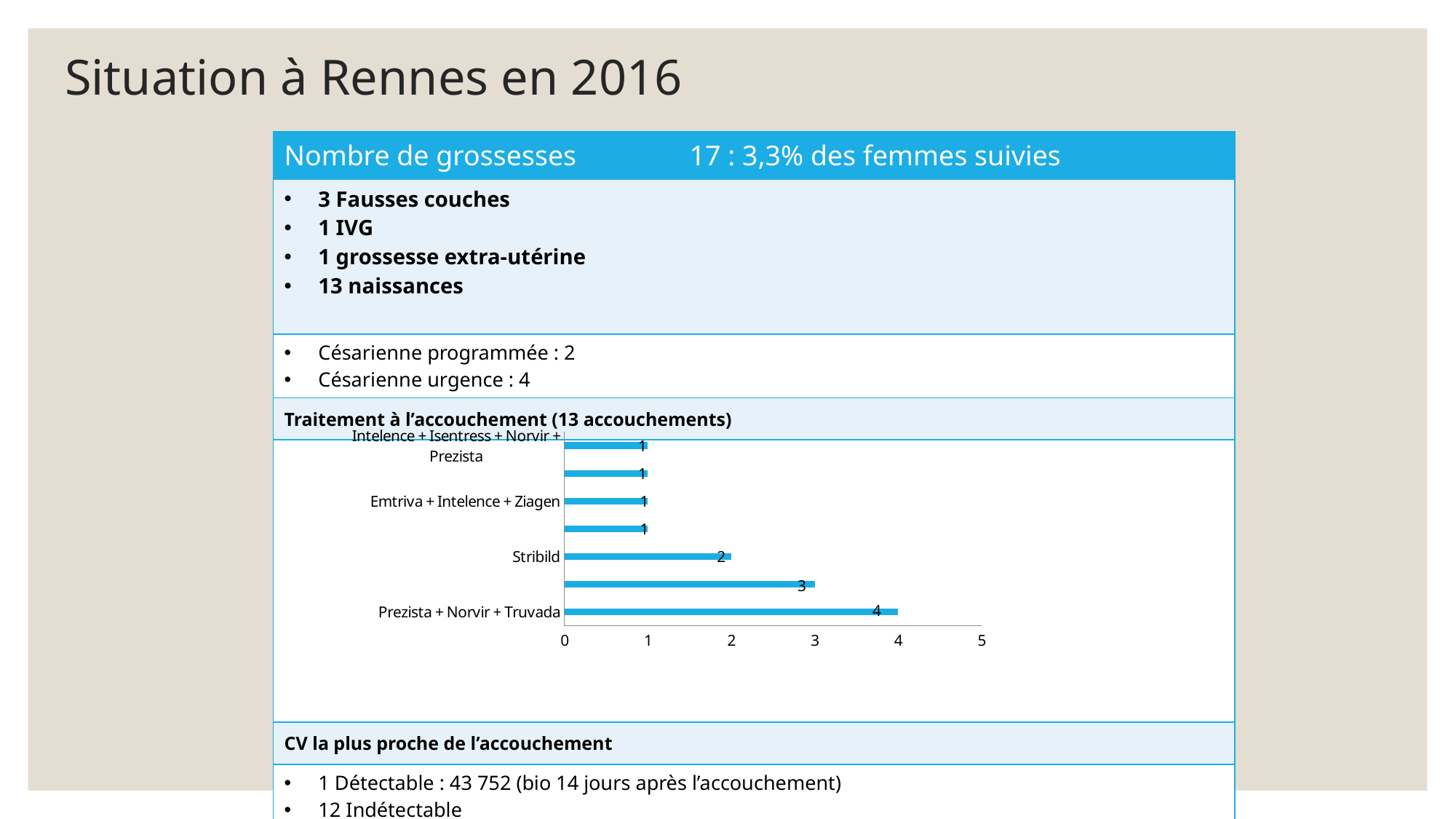
Which is larger, the value for Stribild or the value for Emtriva + Intelence + Ziagen? Stribild Is the value for Prezista + Norvir + Truvada greater or less than 3? greater What is the value for Emtriva + Intelence + Ziagen? 1 What is the difference between the values for Prezista + Norvir + Truvada and Stribild? 2 What is the title of the section containing the chart? Traitement à l'accouchement (13 accouchements) What is the value for Prezista + Norvir + Truvada? 4 Which treatment has the highest value in the chart? Prezista + Norvir + Truvada What is the value for Stribild? 2 What kind of chart is shown under "Traitement à l'accouchement"? bar chart How many bars are plotted in the chart? 7 What is the value for Intelence + Isentress + Norvir + Prezista? 1 What is the highest value shown on the x axis of the chart? 5